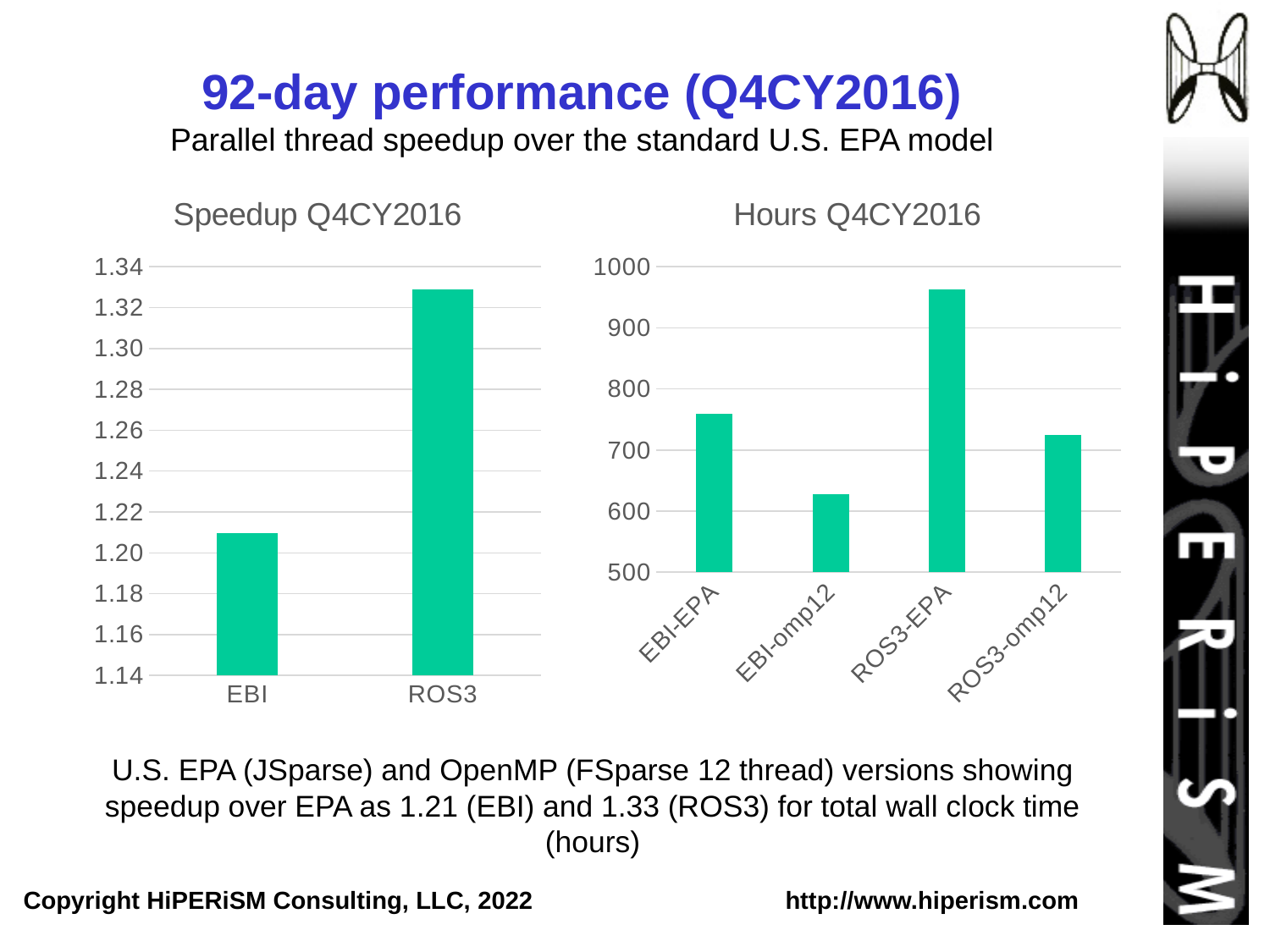
What type of chart is the Hours Q4CY2016 chart? bar chart In the Speedup Q4CY2016 chart, what is the speedup value for ROS3? 1.33 In the Hours Q4CY2016 chart, is the value for EBI-omp12 greater or less than 700? less In the Hours Q4CY2016 chart, how many categories are plotted? 4 In the Hours Q4CY2016 chart, which is larger, the value for EBI-EPA or the value for ROS3-omp12? EBI-EPA In the Hours Q4CY2016 chart, is the value for ROS3-EPA greater or less than 900? greater In the Speedup Q4CY2016 chart, how many categories are plotted? 2 In the Hours Q4CY2016 chart, which category has the highest value? ROS3-EPA In the Speedup Q4CY2016 chart, what is the speedup value for EBI? 1.21 In the Hours Q4CY2016 chart, is the value for EBI-EPA greater or less than 700? greater In the Hours Q4CY2016 chart, which category has the lowest value? EBI-omp12 In the Speedup Q4CY2016 chart, which category has the higher speedup? ROS3